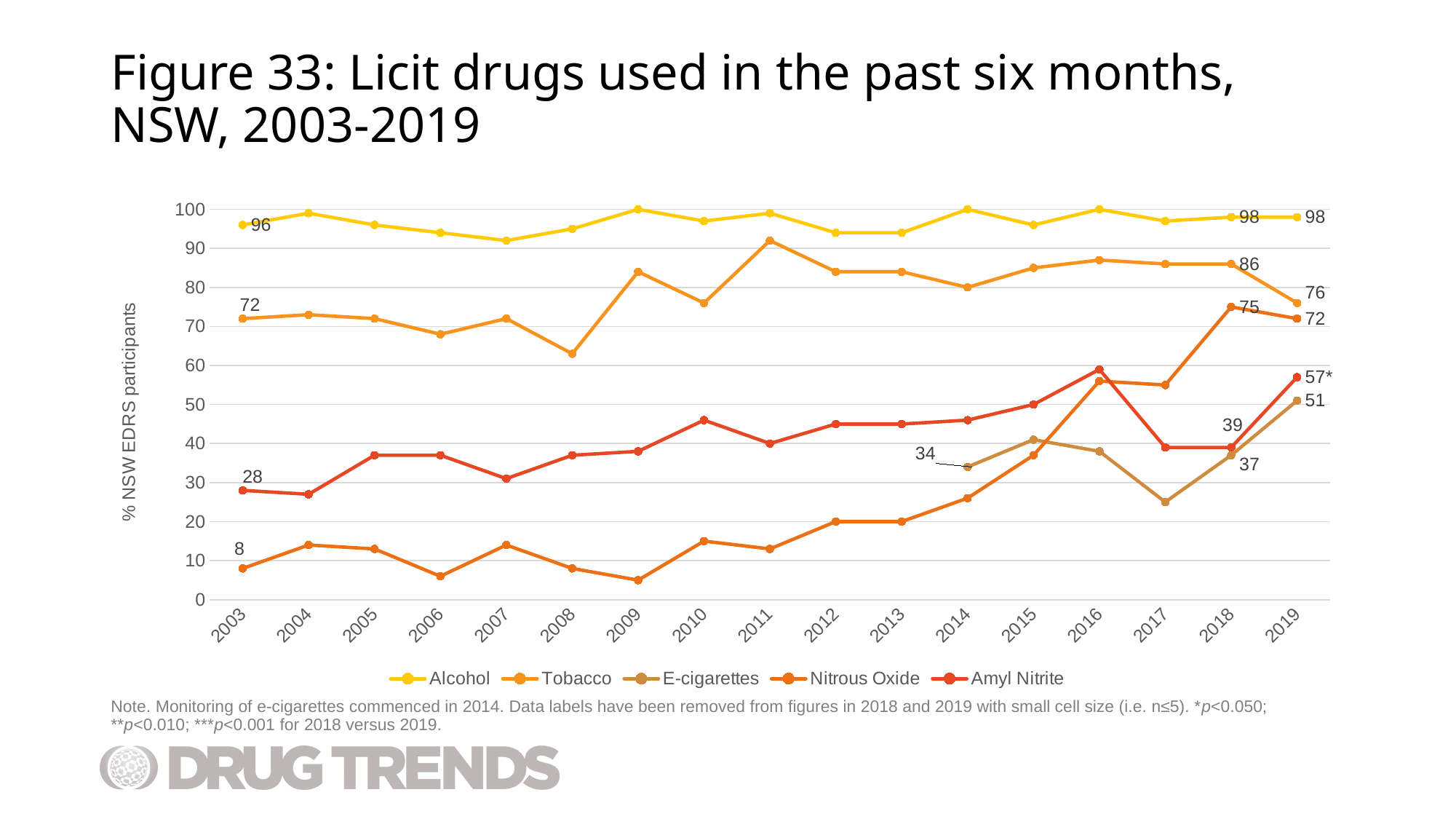
What is the data label for Amyl Nitrite in 2019? 57* What was the value for Tobacco in 2019? 76 How many years are shown on the x axis? 17 What was the value for Alcohol in 2003? 96 What kind of chart is shown on the slide? line chart Which series has the highest value in 2019? Alcohol By how much did the Tobacco value fall from 2018 to 2019? 10 In 2019, which is larger: Nitrous Oxide or Amyl Nitrite? Nitrous Oxide How many series does the legend list? 5 Is the value for Nitrous Oxide in 2009 greater or less than 10? less What was the value for Nitrous Oxide in 2003? 8 What was the value for E-cigarettes in 2014? 34